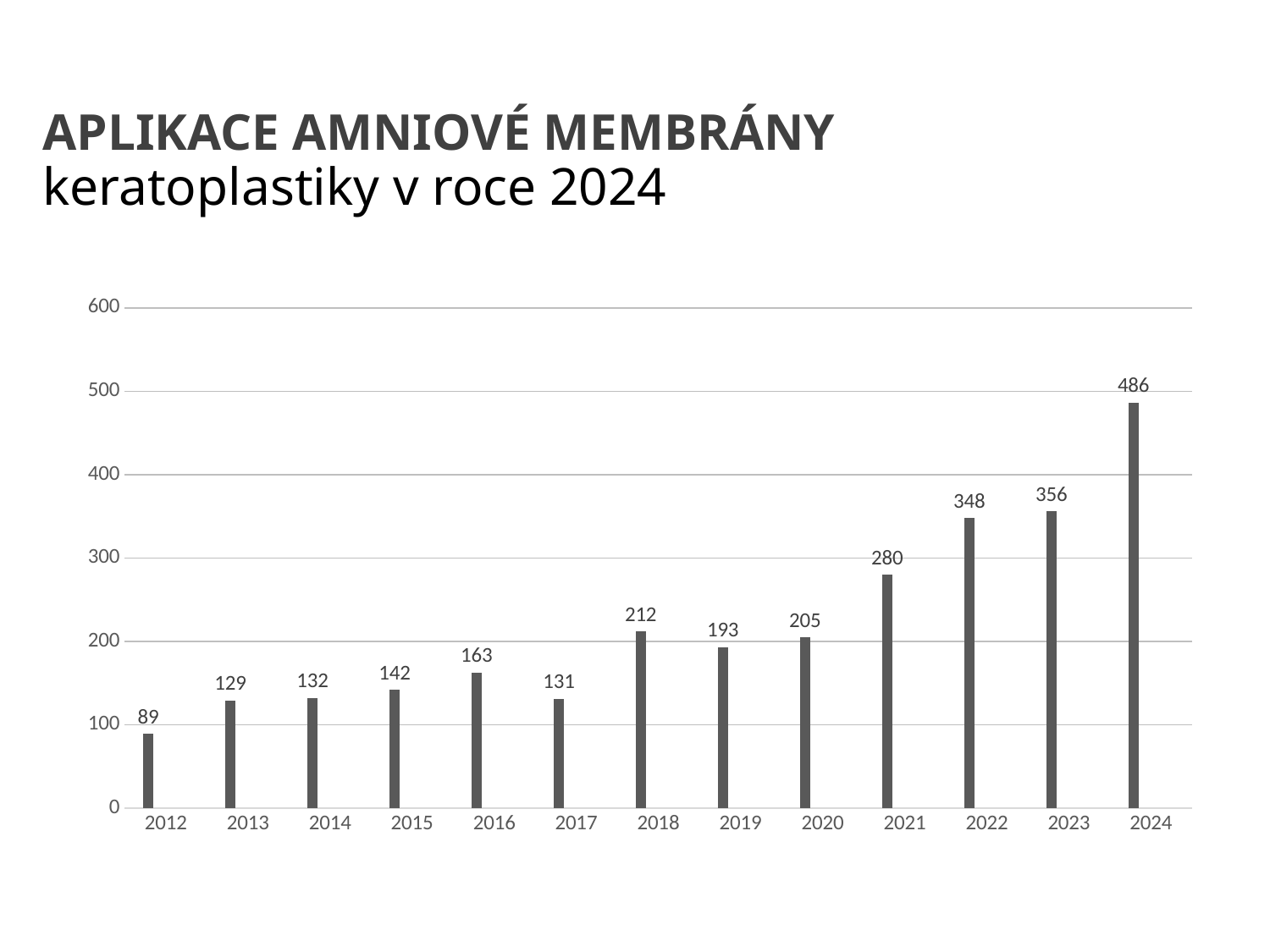
Which is larger, the value for 2018 or the value for 2019? 2018 Which year has the highest value? 2024 What is the value for 2017? 131 What is the value for 2024? 486 Which year has the lowest value? 2012 What is the value for 2012? 89 How many years are shown on the x axis? 13 What kind of chart is shown on the slide? bar chart Do the values generally rise or fall from 2012 to 2024? rise What is the difference between the values for 2021 and 2020? 75 What is the difference between the values for 2024 and 2023? 130 Is the value for 2022 greater or less than 300? greater